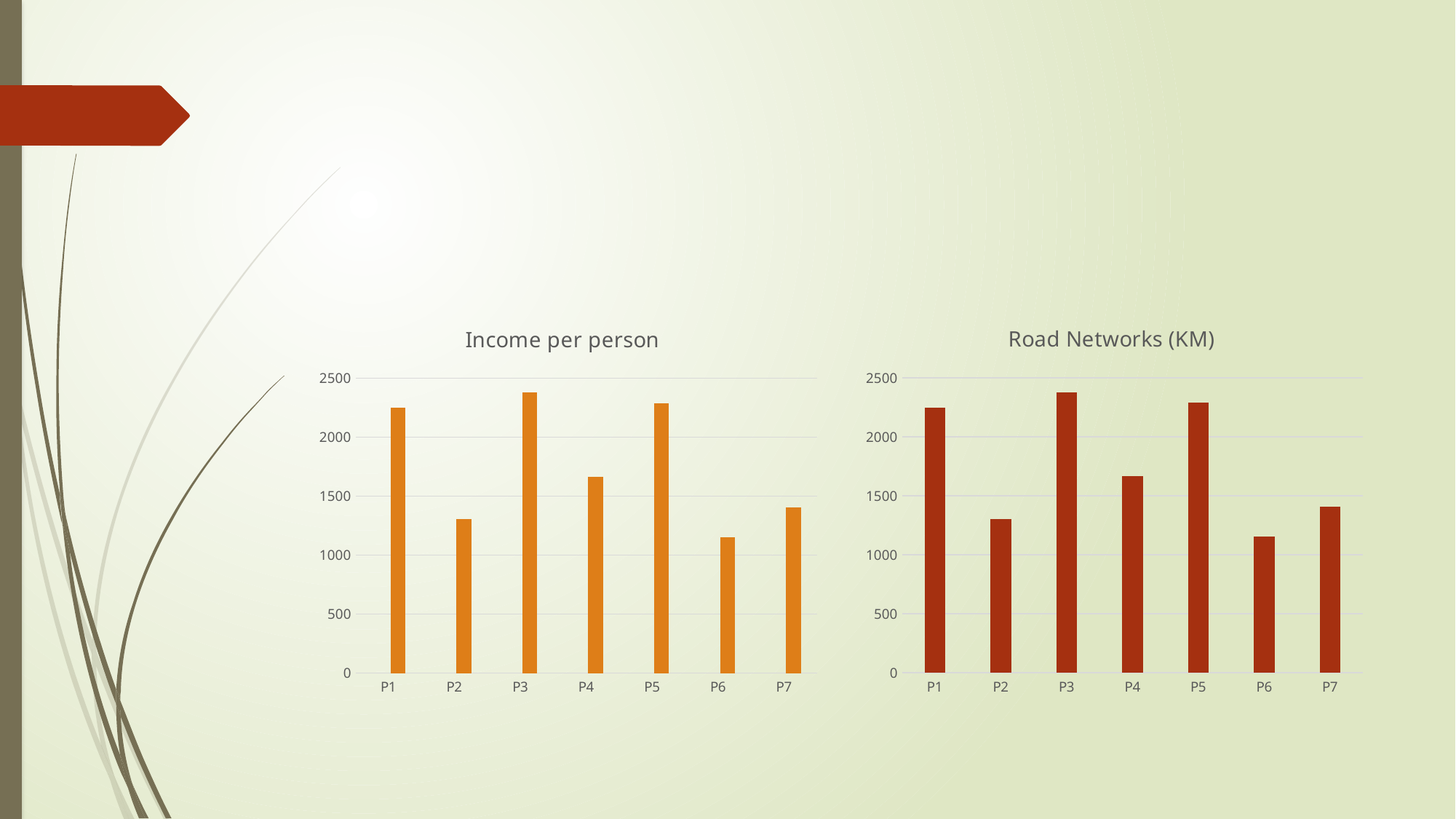
In the "Road Networks (KM)" chart, which is larger, the value for P7 or the value for P1? P1 In the "Road Networks (KM)" chart, is the value for P4 greater or less than 1500? greater In the "Income per person" chart, is the value for P6 greater or less than 1000? greater What kind of chart is the "Income per person" chart? bar chart How many categories are shown on the x axis of the "Road Networks (KM)" chart? 7 In the "Road Networks (KM)" chart, which category has the highest value? P3 In the "Income per person" chart, is the value for P1 greater or less than 2000? greater In the "Income per person" chart, which category has the lowest value? P6 What is the title of the chart on the right side of the slide? Road Networks (KM) What colour are the bars in the "Income per person" chart? orange In the "Income per person" chart, which is larger, the value for P4 or the value for P2? P4